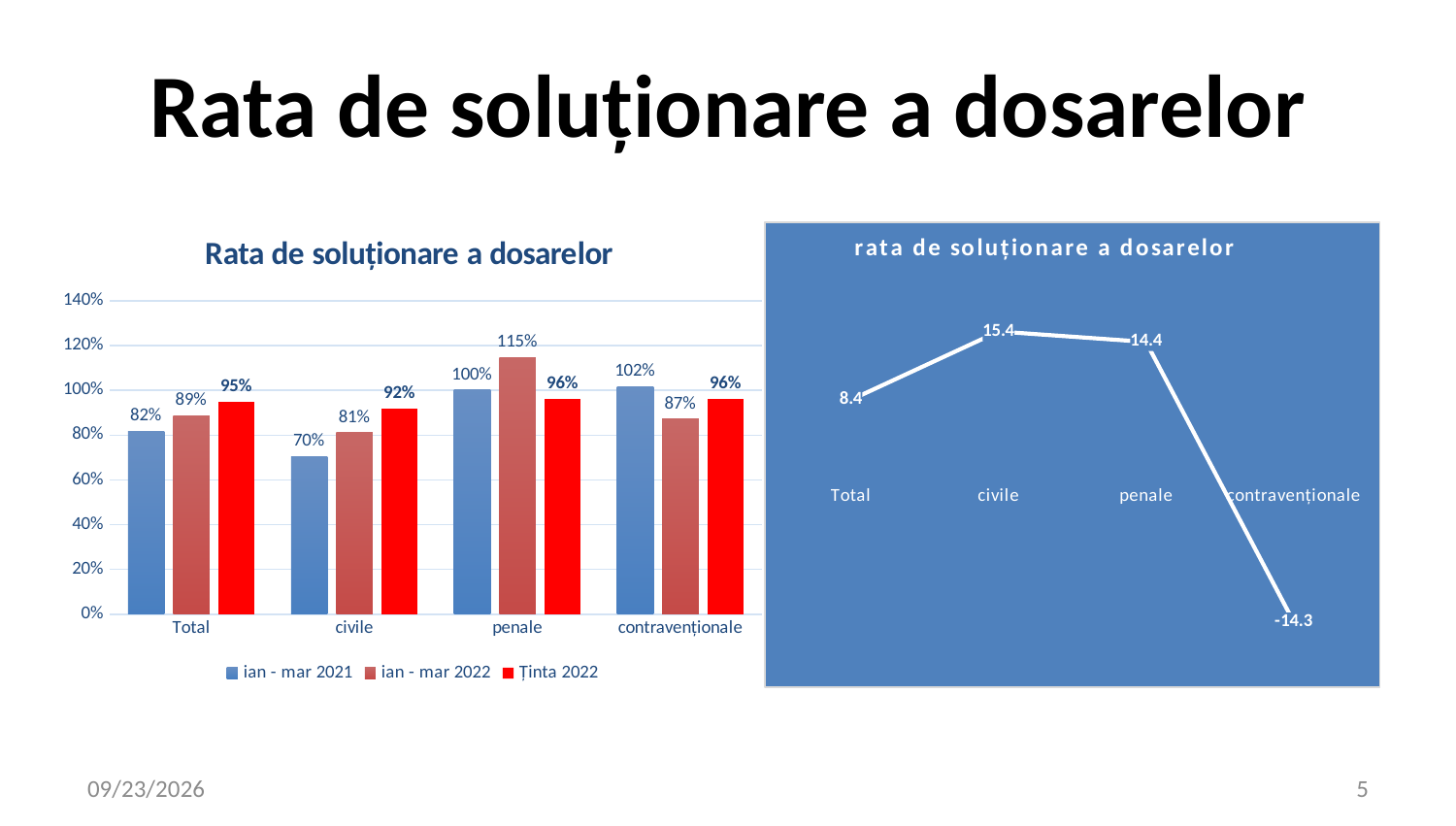
How many series does the legend of the left bar chart list? 3 What kind of chart is the chart on the right side of the slide? line chart In the left bar chart, which category has the lowest ian - mar 2021 value? civile In the right line chart, which category has the lowest value? contravenționale In the left bar chart, what is the Ținta 2022 value for penale? 96% In the left bar chart, for contravenționale, which is larger: the ian - mar 2021 value or the ian - mar 2022 value? ian - mar 2021 In the left bar chart, which category has the highest ian - mar 2022 value? penale In the left bar chart, what is the difference between the ian - mar 2022 value and the ian - mar 2021 value for Total? 7% In the right line chart, what is the difference between the values for civile and penale? 1 In the right line chart, what is the value for civile? 15.4 How many categories are shown on the x axis of the right line chart? 4 In the left bar chart, what is the value for civile in the ian - mar 2021 series? 70%